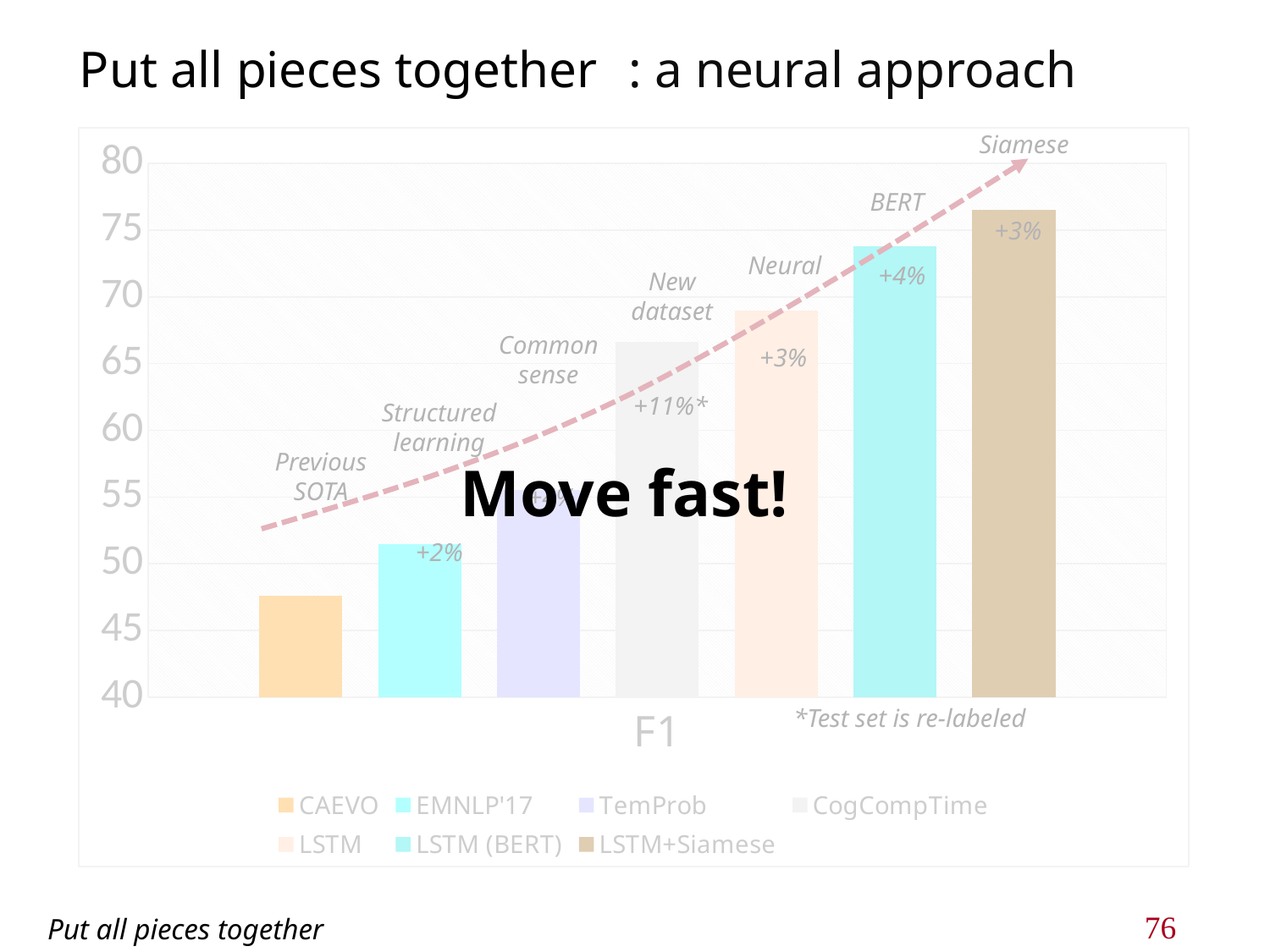
Which series has the highest F1 bar? LSTM+Siamese What kind of chart is shown on the slide? bar chart Do the bars rise or fall from left to right across the series? rise Is the F1 value for CAEVO greater or less than 50? less Is the F1 value for LSTM+Siamese greater or less than 75? greater Is the F1 value for CogCompTime greater or less than 65? greater Which series has the lowest F1 bar? CAEVO What improvement label is printed on the CogCompTime bar? +11%* What is the label on the x axis of the chart? F1 How many categories are shown on the x axis? 1 Which is larger, the F1 bar for LSTM (BERT) or the F1 bar for LSTM? LSTM (BERT) How many series does the legend list? 7